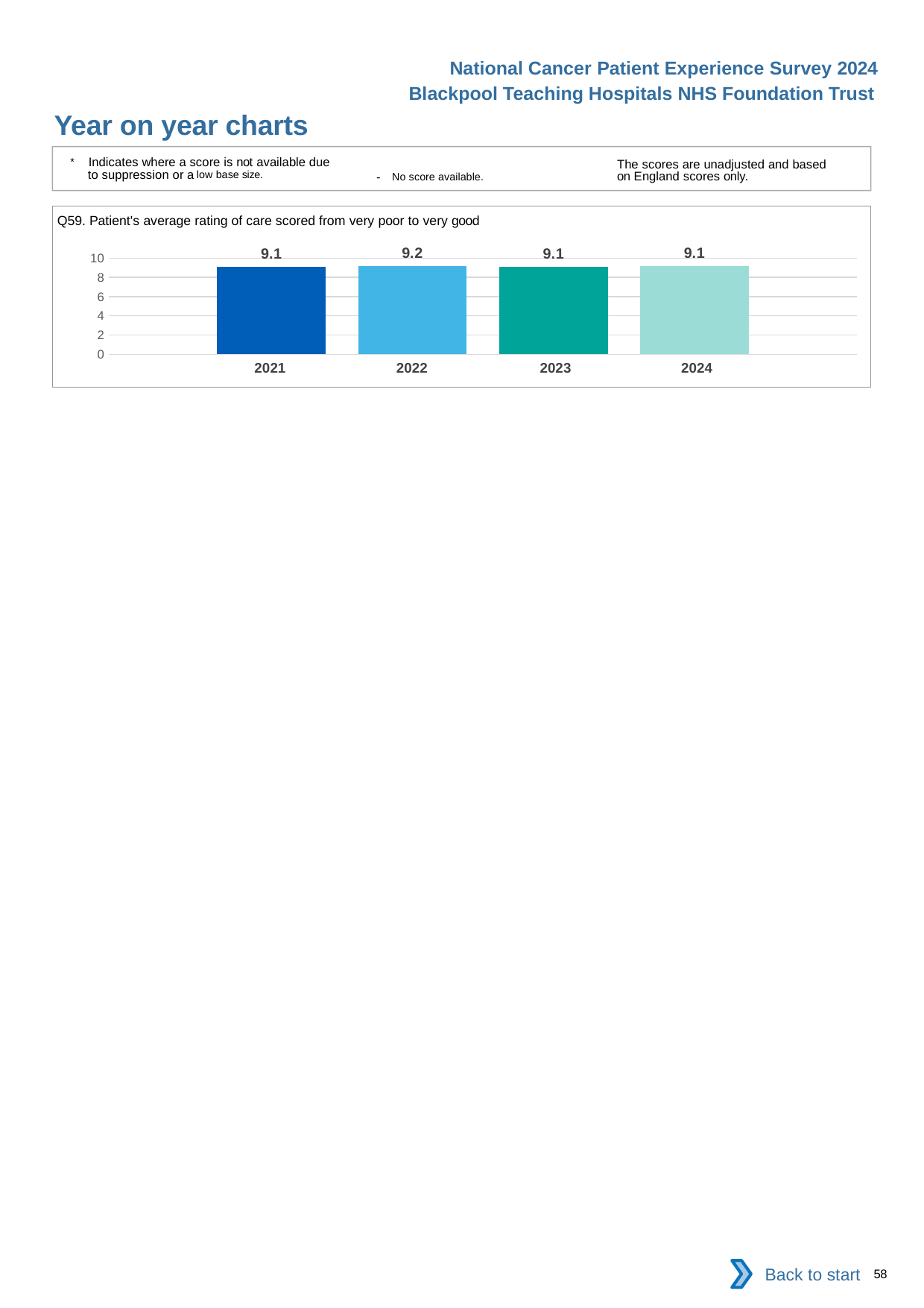
What is the value for 2022? 9.2 Which year has the highest value? 2022 Is the value for 2024 greater or less than 8? greater What is the title of the chart? Q59. Patient's average rating of care scored from very poor to very good What is the value for 2024? 9.1 How many years are shown on the chart? 4 What kind of chart is shown? bar chart What is the value for 2023? 9.1 Which is larger, the value for 2022 or the value for 2023? 2022 What is the value for 2021? 9.1 What is the difference between the values for 2022 and 2021? 0.1 What is the maximum value shown on the y axis? 10